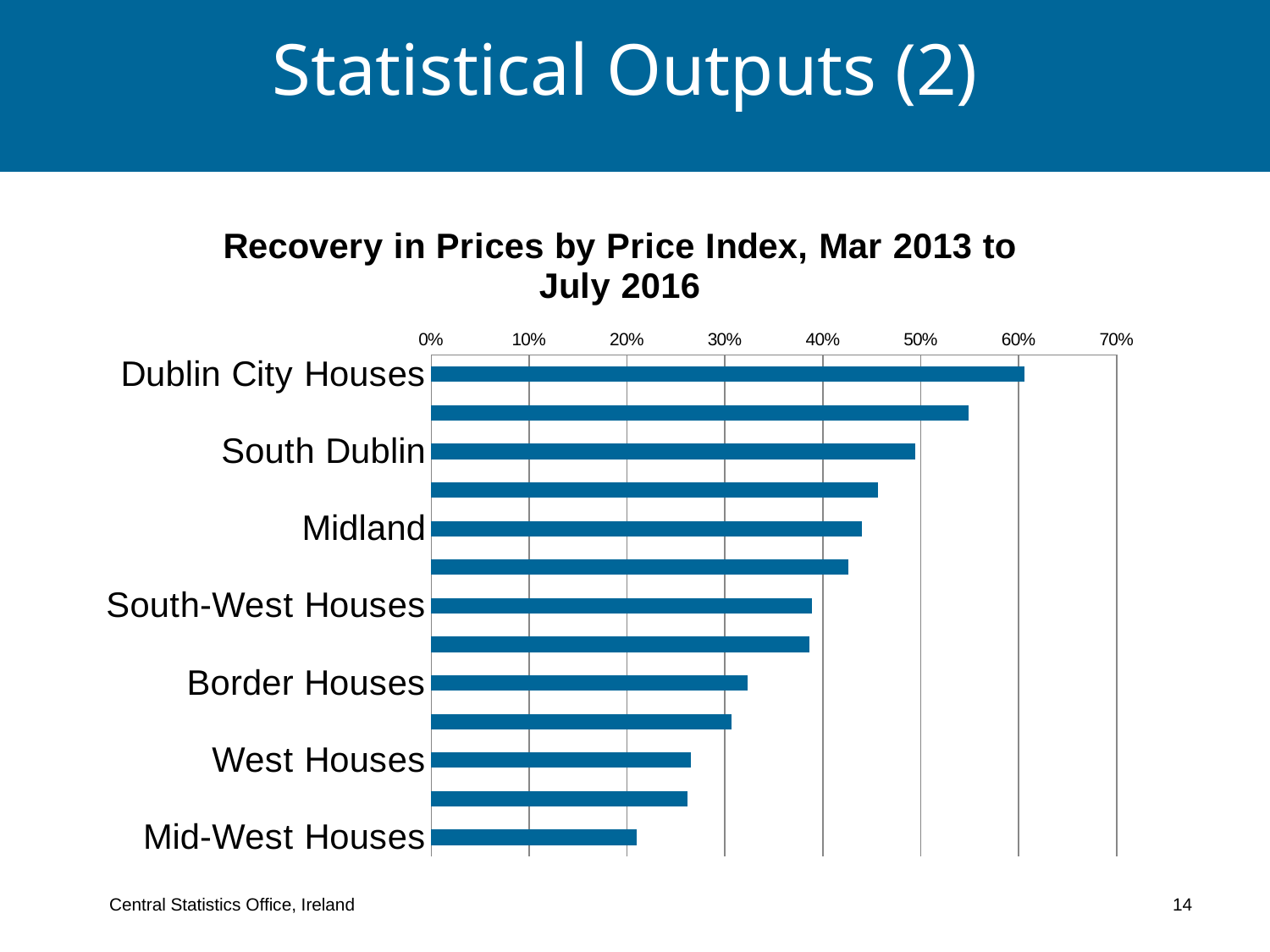
Do the bar values increase or decrease going from the top of the chart to the bottom? Decrease What is the title of the chart? Recovery in Prices by Price Index, Mar 2013 to July 2016 Which is larger, the value for South Dublin or the value for Border Houses? South Dublin Is the value for South-West Houses greater or less than 30%? greater Is the value for Dublin City Houses greater or less than 50%? greater Is the value for Border Houses greater or less than 40%? less How many bars are plotted in the chart? 13 What kind of chart is shown on the slide? Bar chart Which category has the highest value in the chart? Dublin City Houses Which category has the lowest value in the chart? Mid-West Houses